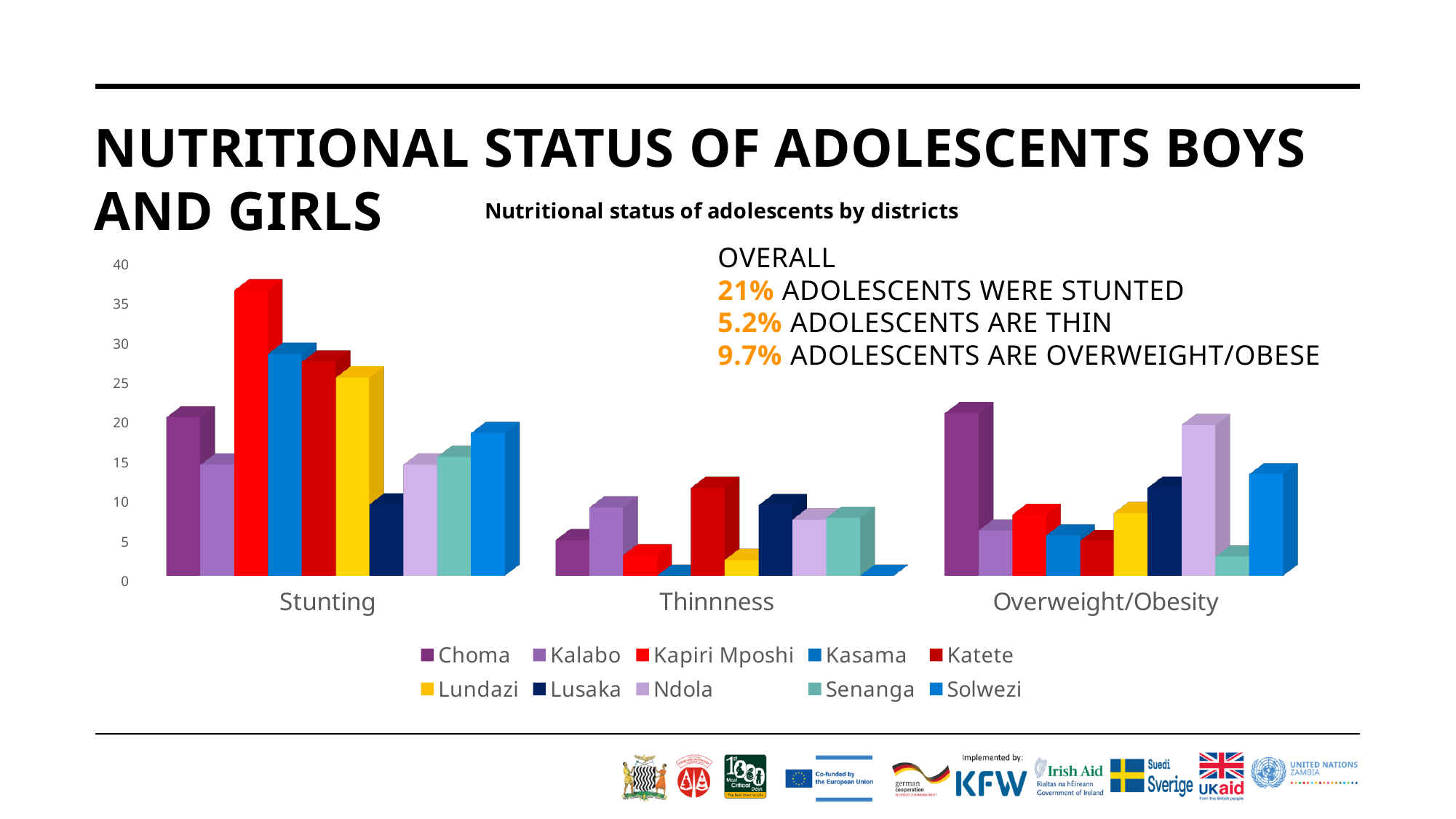
Is the Stunting value for Kapiri Mposhi greater or less than 35? greater What is the title of the chart? Nutritional status of adolescents by districts What kind of chart is shown on the slide? Bar chart Which district has the lowest Stunting value? Lusaka Is the Overweight/Obesity value for Ndola greater or less than 15? greater How many series (districts) does the legend list? 10 Which district has the highest Stunting value? Kapiri Mposhi For Stunting, which is larger: Kapiri Mposhi or Kasama? Kapiri Mposhi Which district has the highest Thinnness value? Katete Is the Stunting value for Lusaka greater or less than 15? less Which district has the lowest Overweight/Obesity value? Senanga How many categories are shown on the x axis of the chart? 3